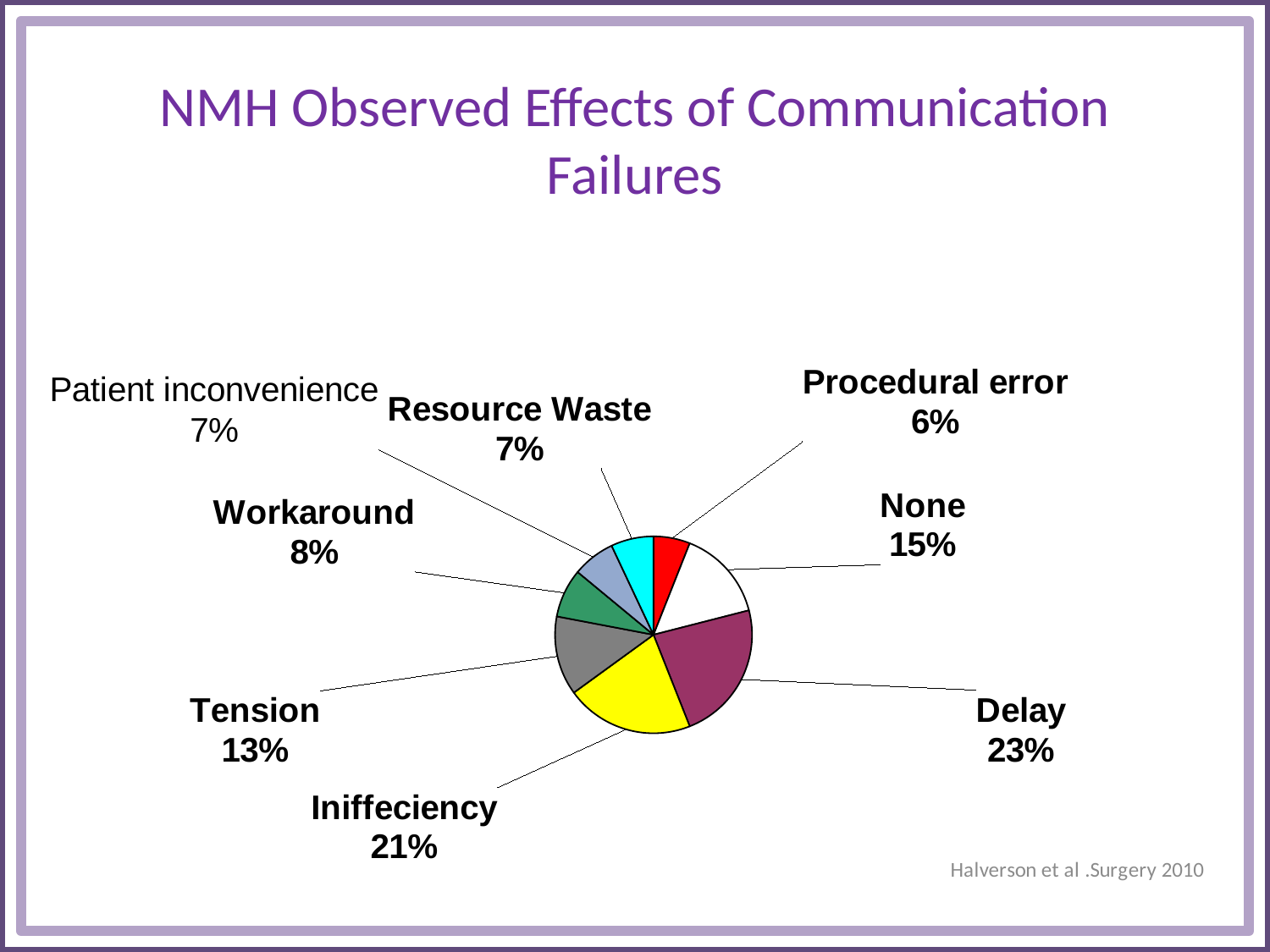
What is the title of the chart on the slide? NMH Observed Effects of Communication Failures Which category has the largest share of the pie? Delay What percentage is shown for None? 15% What percentage is shown for Tension? 13% Which category has the smallest share of the pie? Procedural error What is the difference in percentage points between Delay and Iniffeciency? 2 What percentage of observed effects is labelled Delay? 23% What is the combined percentage of Patient inconvenience and Resource Waste? 14% What kind of chart is shown on the slide? Pie chart How many slices does the pie chart have? 8 Which is larger, the share for None or the share for Tension? None What percentage is shown for Workaround? 8%